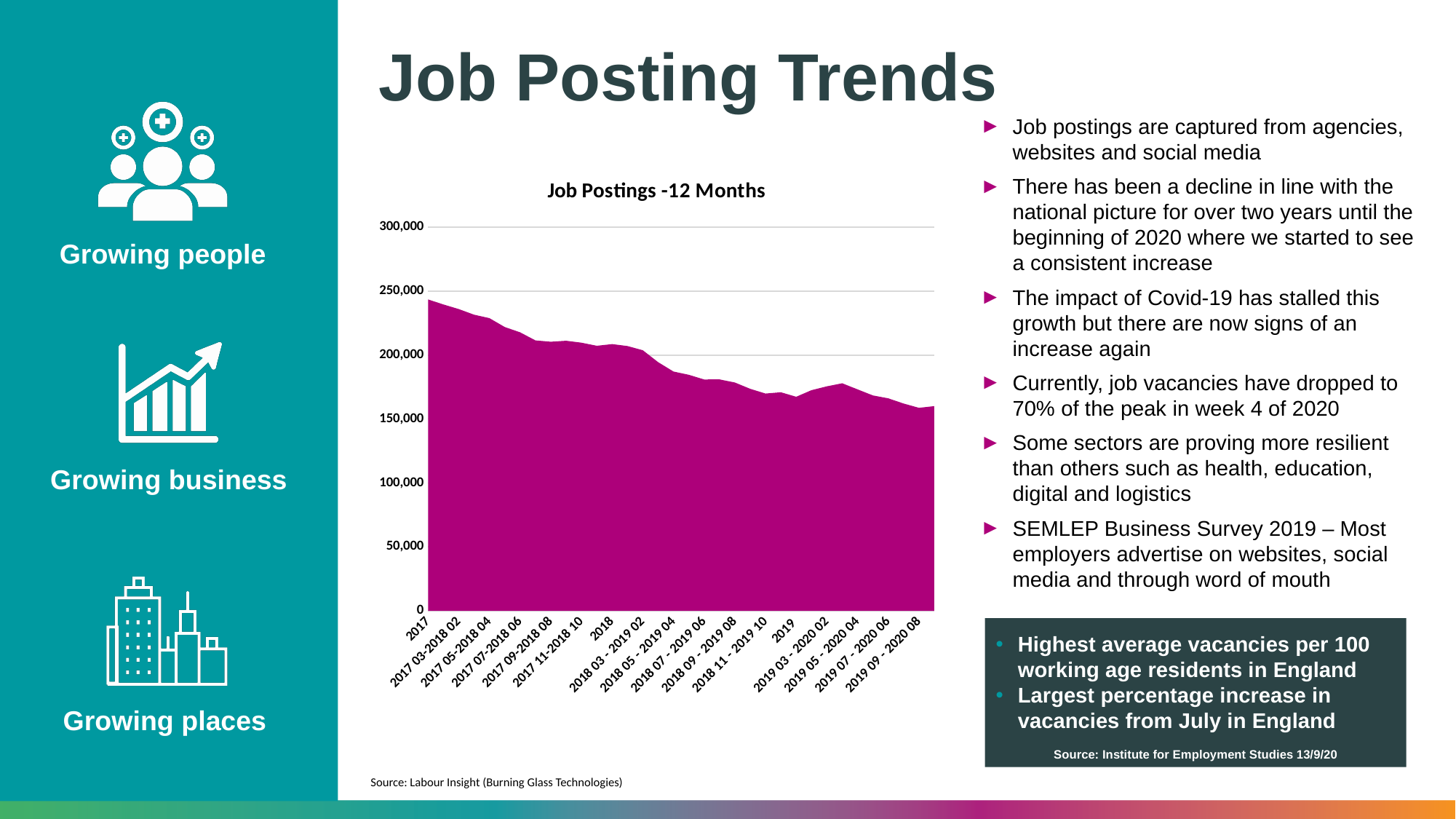
Is the value for 2017 greater or less than 250,000? less Which is larger, the value for 2017 or the value for 2019? 2017 What type of chart is shown on the slide? Area chart What is the highest value shown on the y axis? 300,000 Is the value for 2017 greater or less than 200,000? greater Do the job posting values generally rise or fall from left to right along the x axis? Fall Which period on the x axis has the highest job postings value? 2017 Is the value for 2019 greater or less than 150,000? greater Which period on the x axis has the lowest job postings value? 2019 09 - 2020 08 What is the title of the chart? Job Postings -12 Months